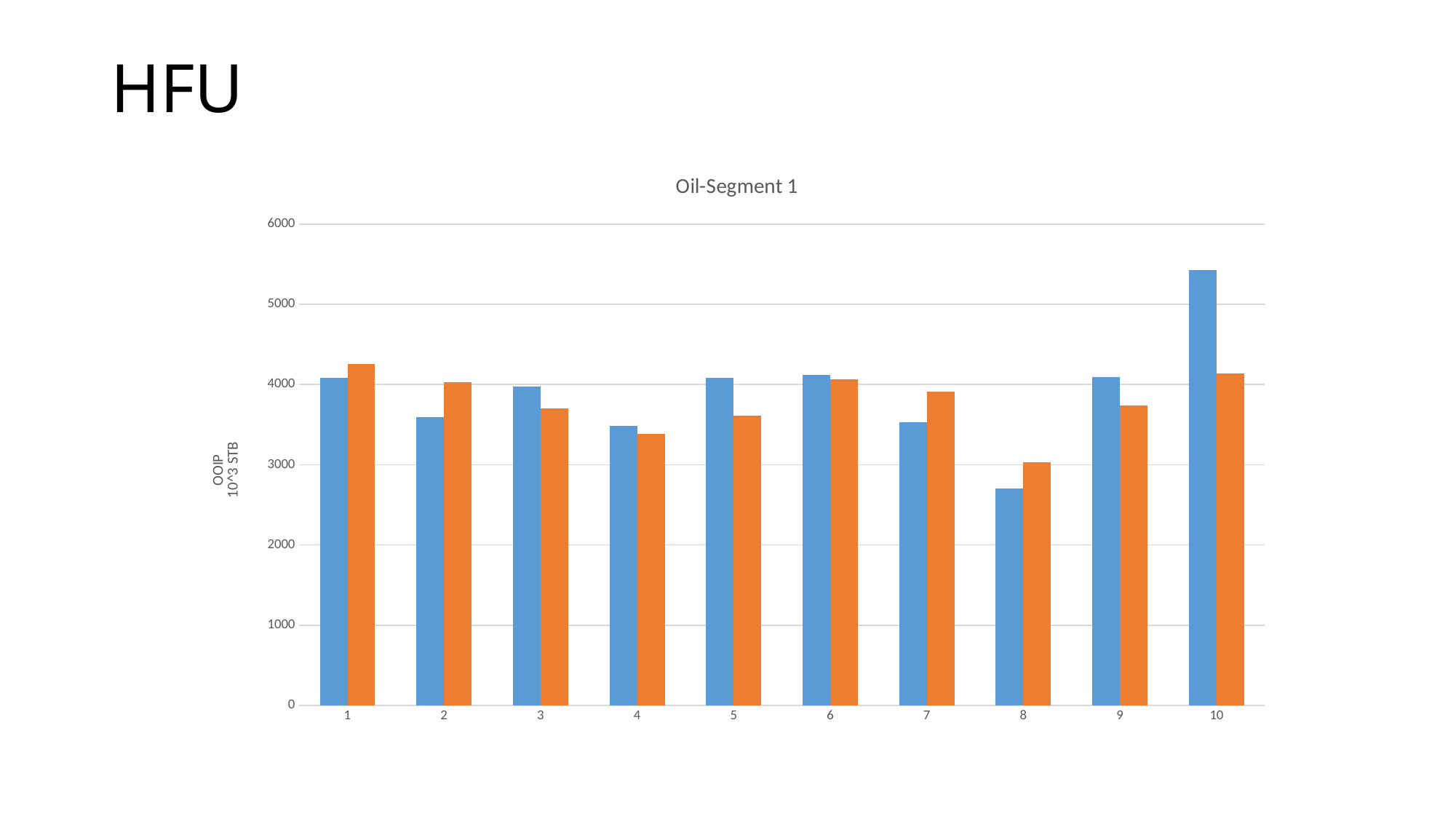
For which category is the blue bar the highest? 10 What is the label on the vertical axis of the chart? OOIP 10^3 STB For which category is the orange bar the lowest? 8 What kind of chart is shown on the slide? bar chart For category 8, which bar is larger, the blue one or the orange one? orange What is the title of the chart? Oil-Segment 1 Is the orange bar for category 1 greater or less than 4000? greater Is the blue bar for category 8 greater or less than 3000? less For category 10, which bar is larger, the blue one or the orange one? blue Is the blue bar for category 10 greater or less than 5000? greater For which category is the blue bar the lowest? 8 How many categories are shown along the x axis of the chart? 10